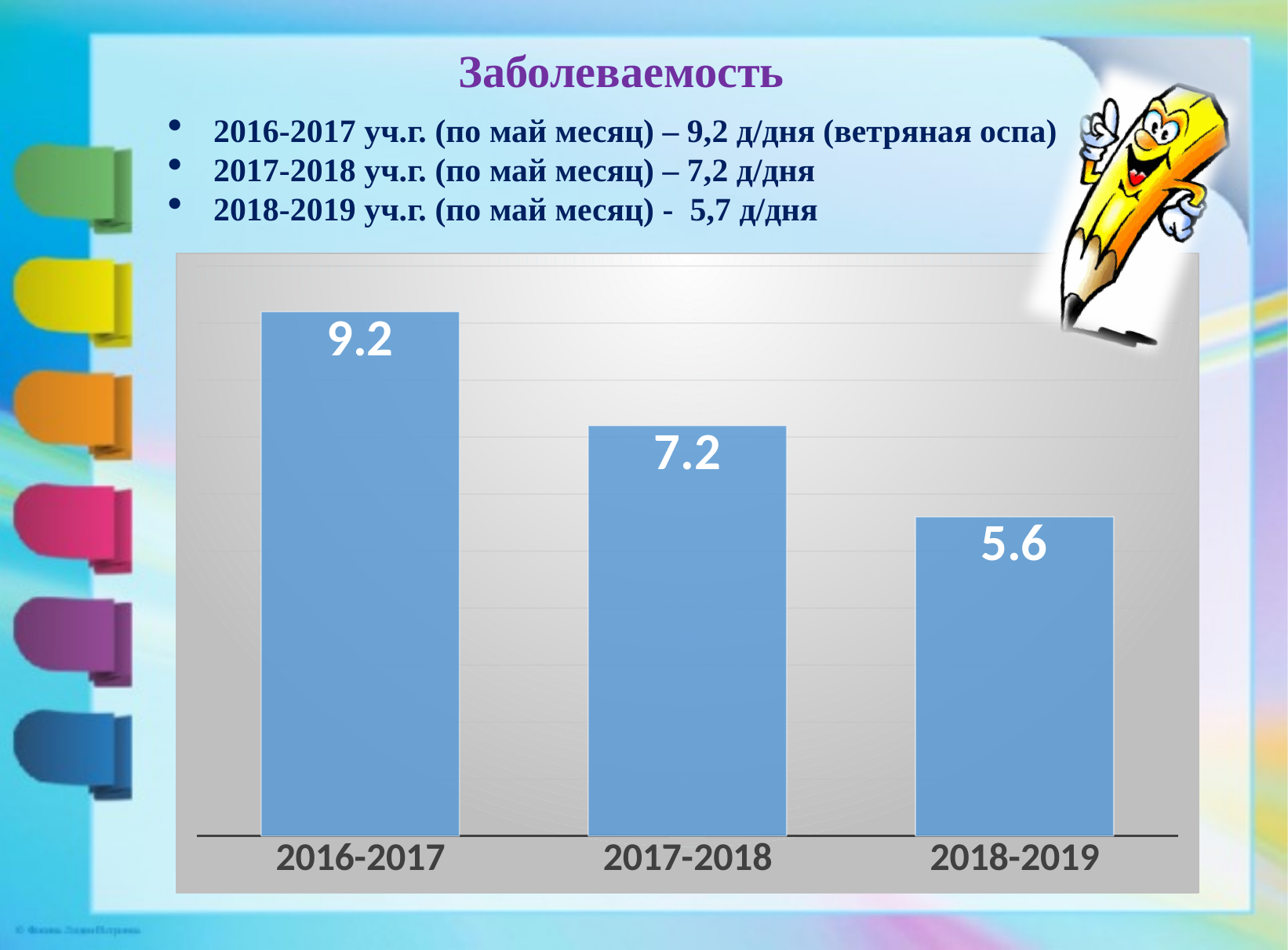
How many categories are shown in the bar chart? 3 What is the value for 2016-2017 in the bar chart? 9.2 What is the value for 2018-2019 in the bar chart? 5.6 What is the value for 2017-2018 in the bar chart? 7.2 What kind of chart is shown on the slide? bar chart What is the difference between the values for 2017-2018 and 2018-2019? 1.6 Do the values rise or fall from 2016-2017 to 2018-2019? fall What is the difference between the values for 2016-2017 and 2017-2018? 2 What is the difference between the values for 2016-2017 and 2018-2019? 3.6 Which category has the highest value in the bar chart? 2016-2017 Which is larger, the value for 2017-2018 or the value for 2018-2019? 2017-2018 Which category has the lowest value in the bar chart? 2018-2019